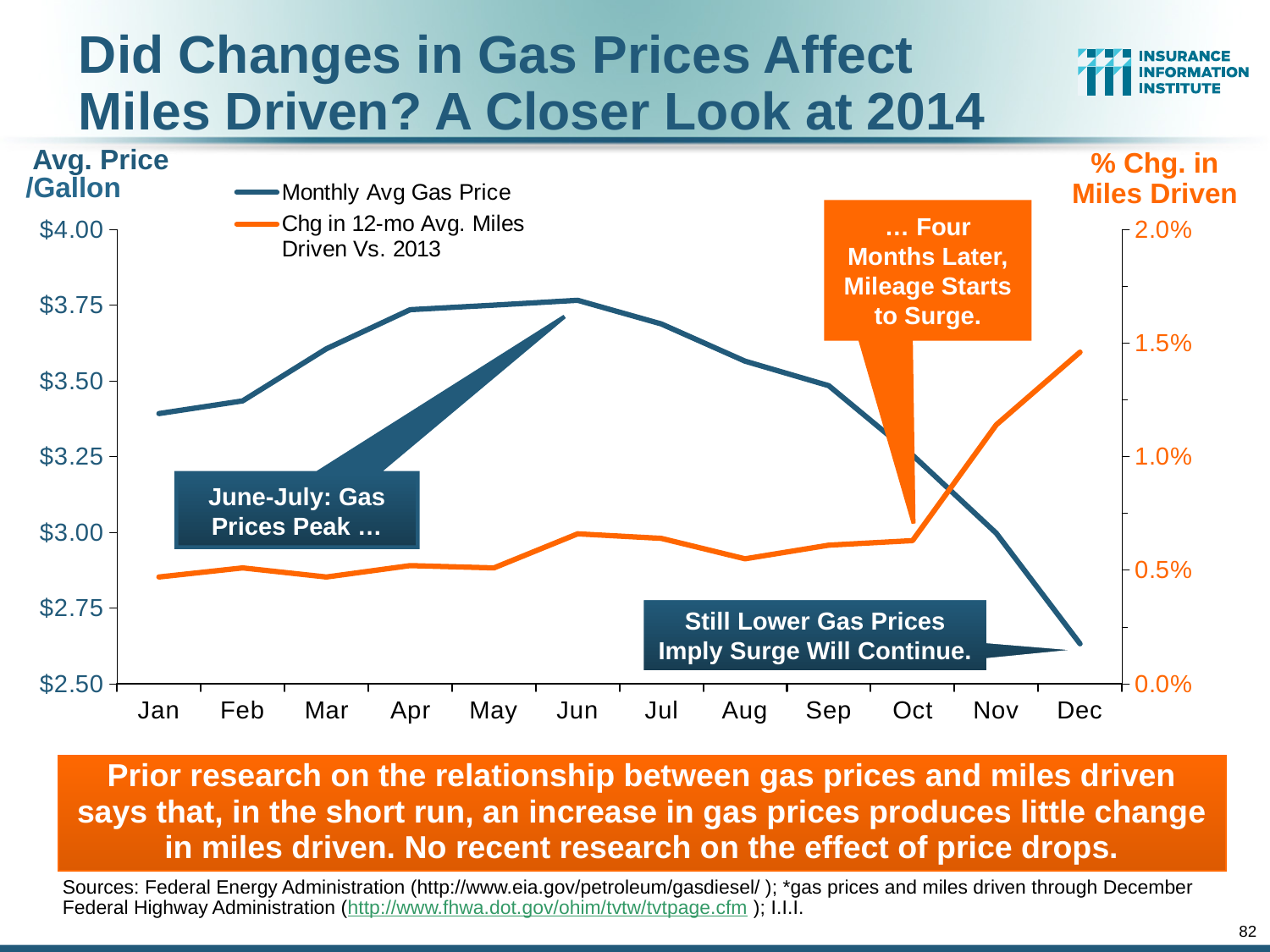
Is the Chg in 12-mo Avg. Miles Driven Vs. 2013 for Dec greater or less than 1.0%? greater What kind of chart is shown on the slide? Line chart Is the Monthly Avg Gas Price for Jan greater or less than $3.25? greater In which month is the Monthly Avg Gas Price lowest? Dec In which month is the Monthly Avg Gas Price highest? Jun In which month is the Chg in 12-mo Avg. Miles Driven Vs. 2013 highest? Dec Which month has the higher Monthly Avg Gas Price, Apr or Nov? Apr Does the Monthly Avg Gas Price rise or fall from Jun to Dec? Fall How many months are plotted along the x axis? 12 Is the Chg in 12-mo Avg. Miles Driven Vs. 2013 for Oct greater or less than 1.0%? less How many series does the legend list? 2